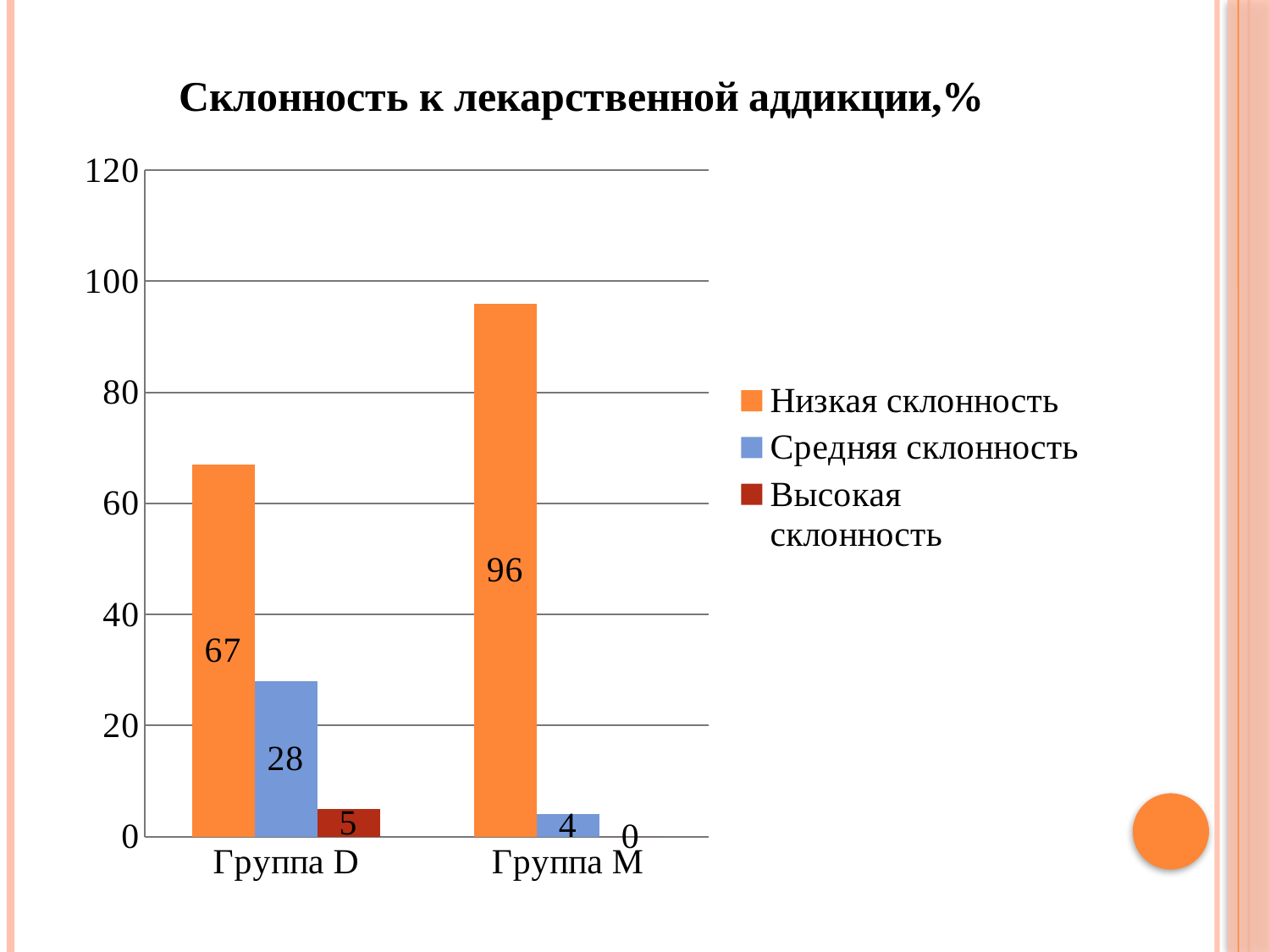
How many series does the legend list? 3 What is the value of Высокая склонность for Группа D? 5 What is the value of Низкая склонность for Группа M? 96 What is the title of the chart? Склонность к лекарственной аддикции,% Is the Средняя склонность value for Группа D larger or smaller than the Средняя склонность value for Группа M? larger What is the value of Низкая склонность for Группа D? 67 How many groups are shown on the x axis? 2 What is the difference between the Низкая склонность values for Группа M and Группа D? 29 What kind of chart is shown on the slide? bar chart Which group has the higher value for Низкая склонность? Группа M Which series has the lowest value for Группа M? Высокая склонность What is the value of Средняя склонность for Группа M? 4